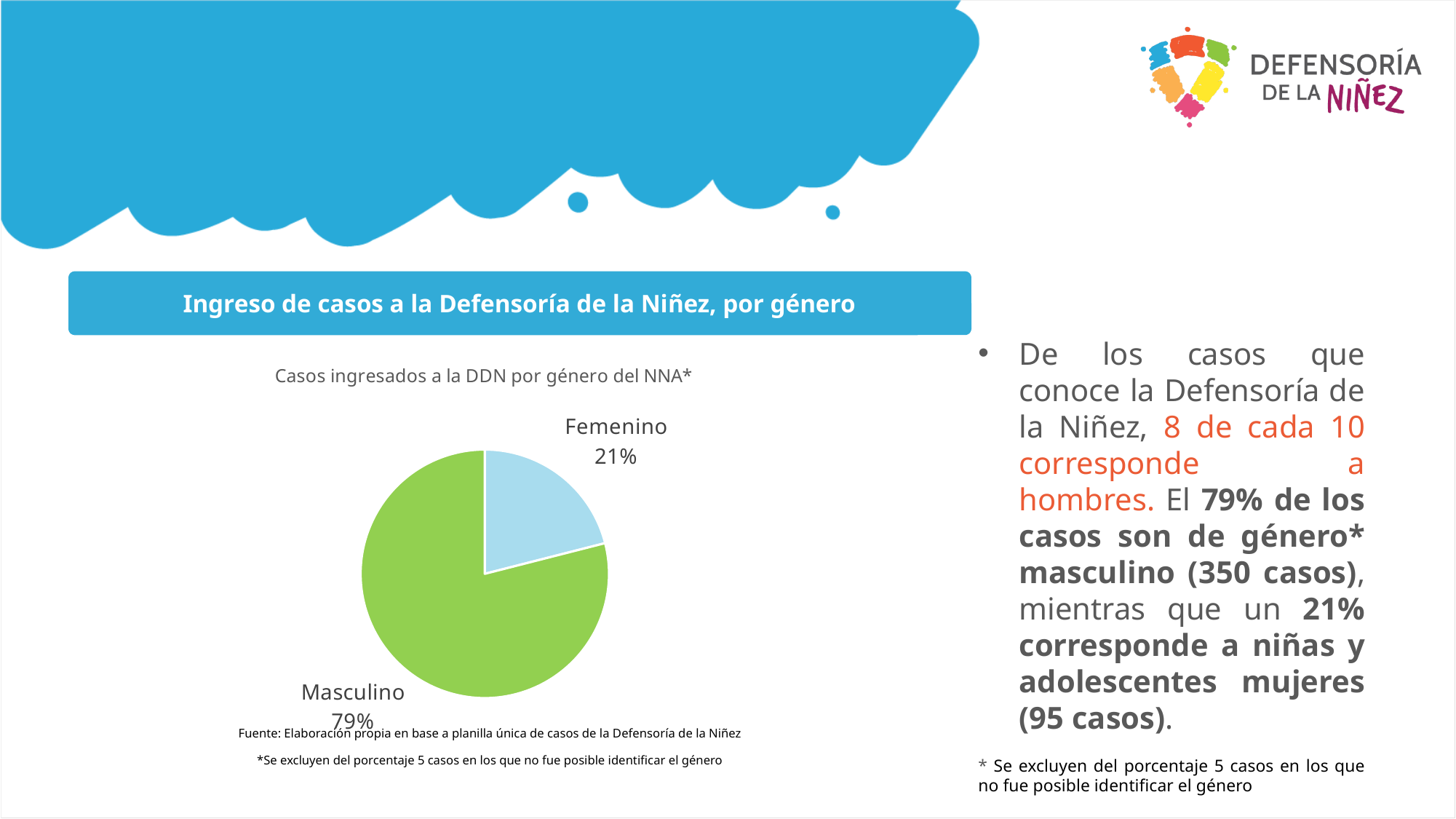
Which category has the smallest slice of the pie? Femenino Which slice is larger, Masculino or Femenino? Masculino How many categories are shown in the pie chart? 2 What colour is the Masculino slice? Green What kind of chart is shown on the slide? Pie chart Is the value for Femenino greater or less than 50%? less What is the difference in percentage points between the Masculino and Femenino slices? 58 Which category has the largest slice of the pie? Masculino What share of the pie does Femenino represent? 21% What is the title of the chart? Casos ingresados a la DDN por género del NNA* What share of the pie does Masculino represent? 79%